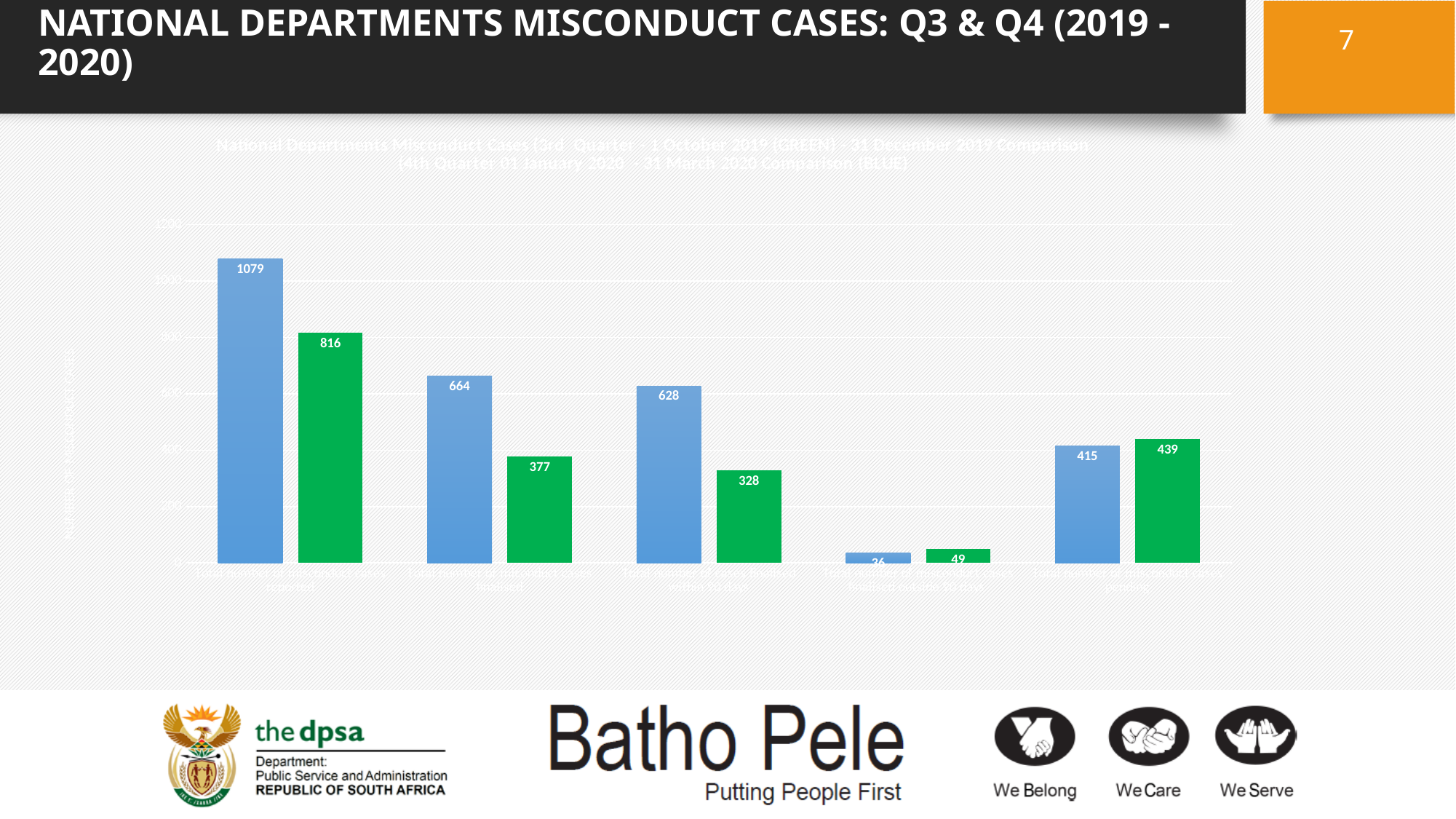
What is the value of the blue bar in the third group of bars from the left? 628 Which bar has the highest value on the chart? The blue bar in the first group (1079) What is the value of the blue bar in the first (leftmost) group of bars? 1079 Which bar has the lowest value on the chart? The blue bar in the fourth group (36) What is the value of the green bar in the rightmost group of bars? 439 In the third group of bars from the left, which is larger, the blue bar or the green bar? The blue bar (628) What is the value of the green bar in the second group of bars from the left? 377 What type of chart is shown on the slide? Bar chart What is the difference between the blue bar (1079) and the green bar (816) in the first group? 263 In the rightmost group of bars, which is larger, the blue bar or the green bar? The green bar (439) How many groups of bars (categories) are shown on the chart? 5 What is the value of the green bar in the first (leftmost) group of bars? 816